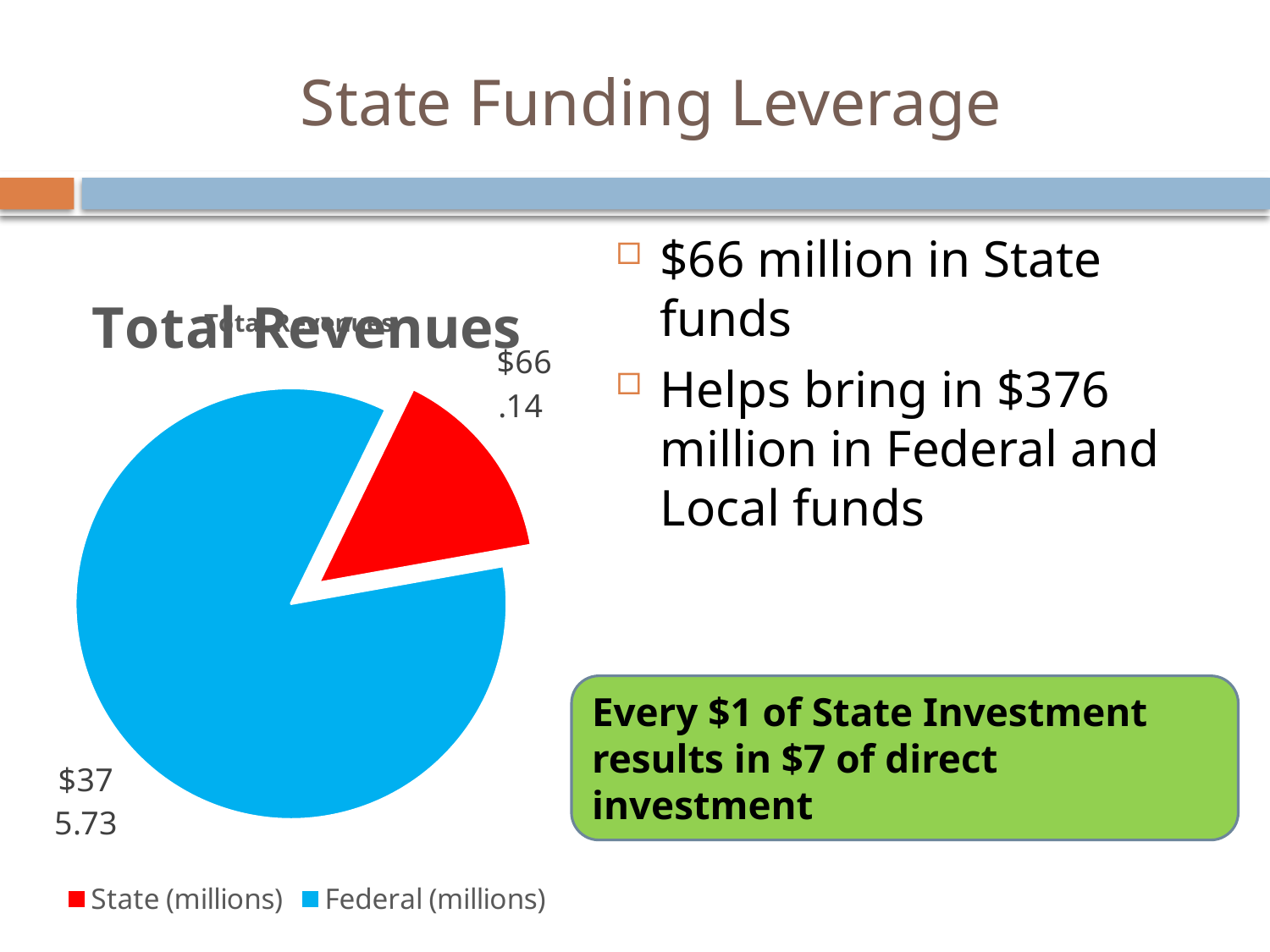
What kind of chart is shown on the slide? pie chart Which is larger, the State (millions) value or the Federal (millions) value? Federal (millions) What is the difference between the Federal (millions) value and the State (millions) value? $309.59 How many slices does the pie chart have? 2 What is the value shown for Federal (millions)? $375.73 What is the value shown for State (millions)? $66.14 What colour is the State (millions) slice? red Which category has the smallest slice of the pie? State (millions) How many entries does the chart legend list? 2 Which category has the largest slice of the pie? Federal (millions) What is the total of the two values shown in the pie chart? $441.87 What is the title of the chart? Total Revenues